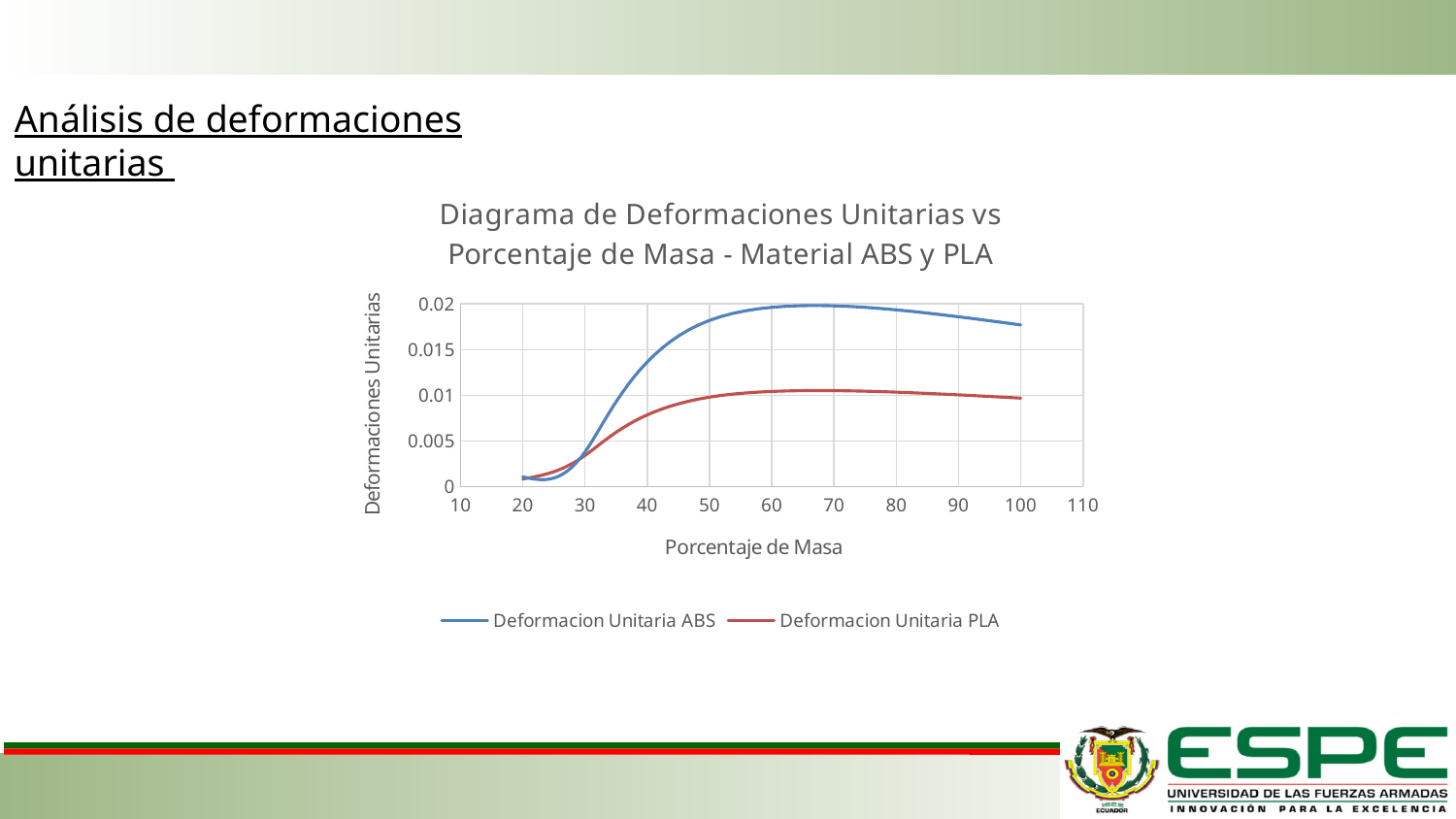
Is the value for Deformacion Unitaria PLA at Porcentaje de Masa 100 greater or less than 0.015? less Is the value for Deformacion Unitaria ABS at Porcentaje de Masa 60 greater or less than 0.015? greater Is the value for Deformacion Unitaria ABS at Porcentaje de Masa 40 greater or less than 0.01? greater Does the Deformacion Unitaria PLA series rise or fall between Porcentaje de Masa 20 and 50? rise What is the label of the x axis? Porcentaje de Masa Does the Deformacion Unitaria ABS series rise or fall between Porcentaje de Masa 20 and 60? rise What is the title of the chart? Diagrama de Deformaciones Unitarias vs Porcentaje de Masa - Material ABS y PLA How many series does the legend list? 2 What kind of chart is shown on the slide? line chart At Porcentaje de Masa 80, which series has the larger value, Deformacion Unitaria ABS or Deformacion Unitaria PLA? Deformacion Unitaria ABS